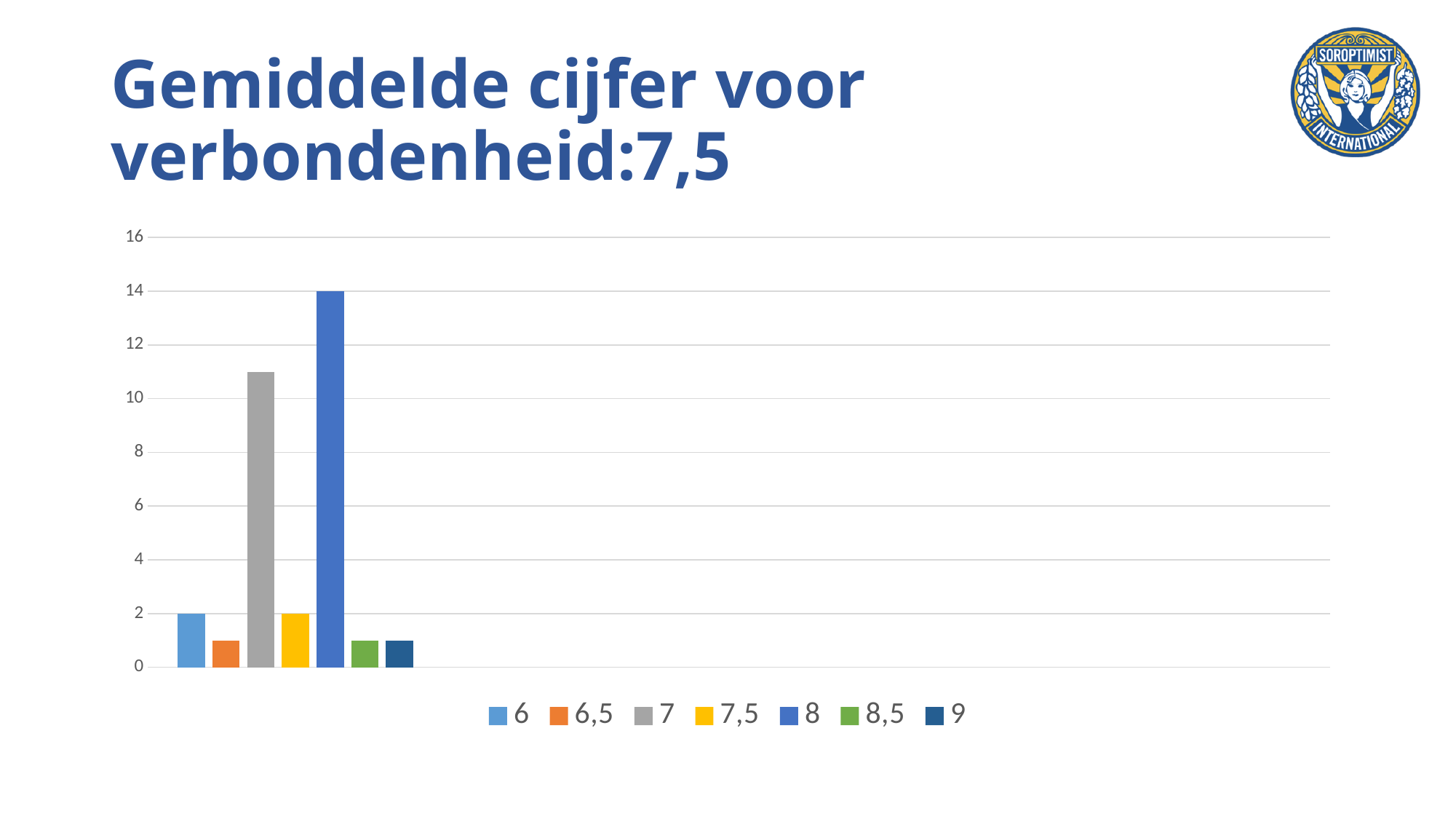
Is the value for series 7 greater or less than 10? greater How many bars are plotted in the chart? 7 What is the difference between the bar for series 8 and the bar for series 6? 12 What is the value of the bar for series 6? 2 Is the value for series 6,5 greater or less than 2? less What is the value of the bar for series 7,5? 2 Which series is shown in grey in the legend? 7 What is the value of the bar for series 8? 14 What kind of chart is shown on the slide? bar chart How many series does the legend list? 7 Which series has the highest bar? 8 Which is larger, the bar for series 7 or the bar for series 8? 8